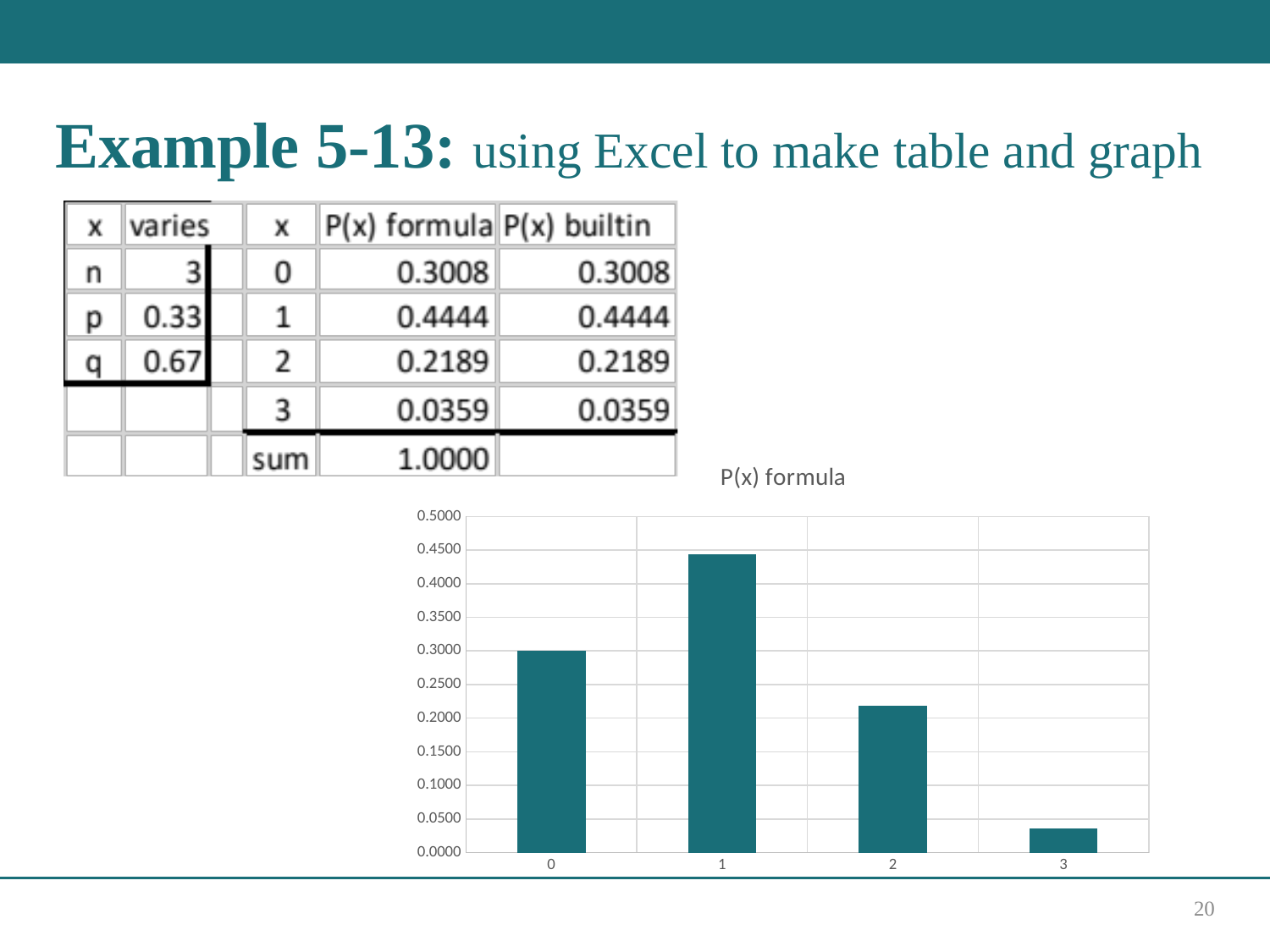
What kind of chart is shown on the slide? bar chart Which x value has the tallest bar in the chart? 1 Is the bar for x = 2 greater or less than 0.2500? less Which bar is taller, x = 0 or x = 2? 0 Do the bars rise or fall from x = 1 to x = 3? fall How many bars does the chart have? 4 According to the table, what is the P(x) formula value plotted for x = 1? 0.4444 According to the table, what is the P(x) formula value plotted for x = 0? 0.3008 Which x value has the shortest bar in the chart? 3 What is the title of the chart? P(x) formula Using the table values, how much larger is P(x) for x = 1 than for x = 0? 0.1436 Is the bar for x = 0 greater or less than 0.2500? greater